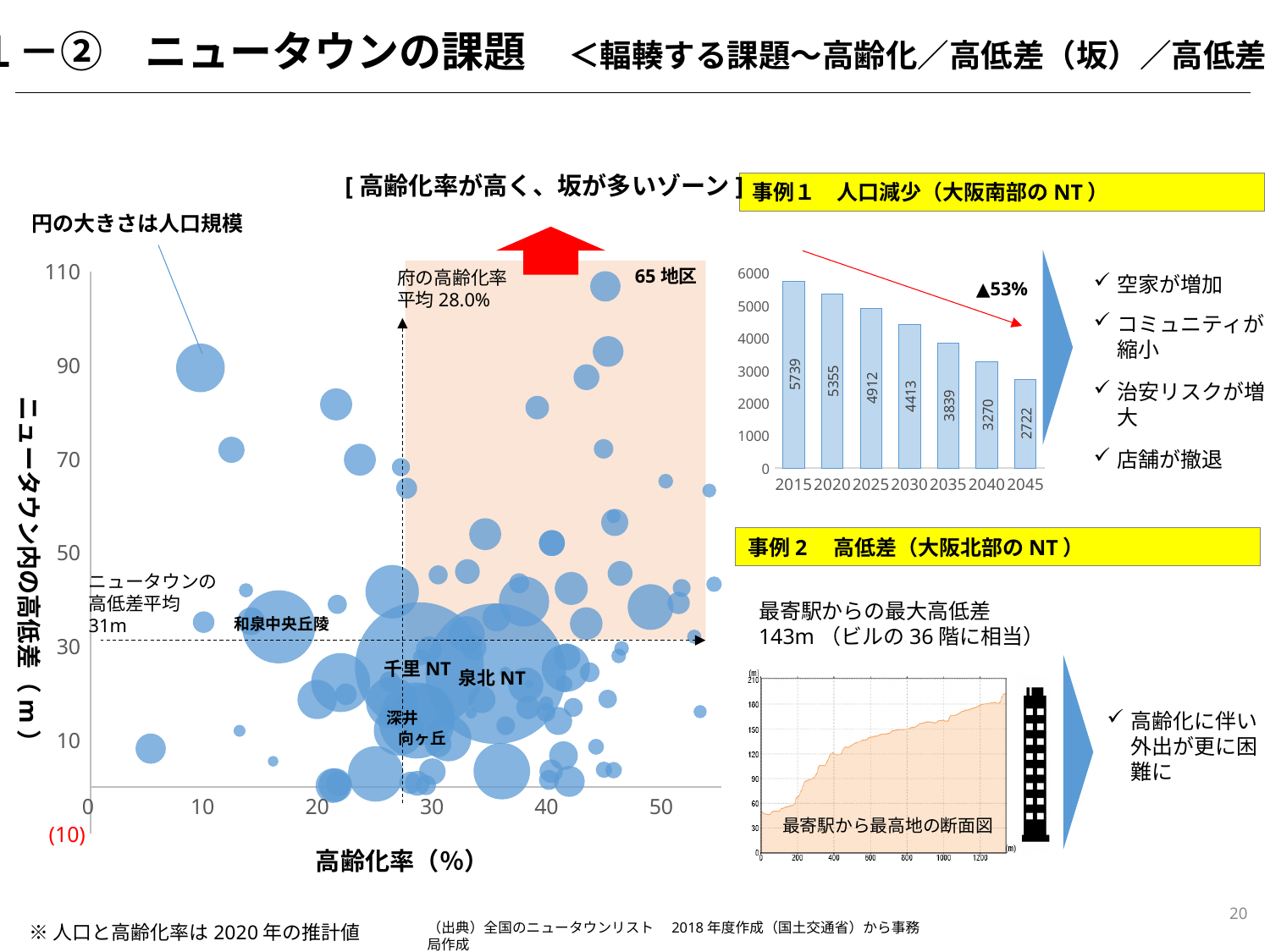
In the bubble chart on the left, what is the prefectural average ageing rate (府の高齢化率平均) marked by the dashed vertical line? 28.0% In the bar chart under 事例1 (人口減少), which year has the lowest value? 2045 In the bubble chart on the left, what is the average elevation difference of new towns (ニュータウンの高低差平均) marked by the dashed horizontal line? 31m In the bar chart under 事例1 (人口減少), what is the value for 2030? 4413 In the bar chart under 事例1 (人口減少), do the values rise or fall from 2015 to 2045? fall In the bar chart under 事例1 (人口減少), what is the value for 2015? 5739 In the bar chart under 事例1 (人口減少), which year has the highest value? 2015 In the bar chart under 事例1 (人口減少), how many years (bars) are shown? 7 In the bar chart under 事例1 (人口減少), what is the difference between the 2015 value and the 2045 value? 3017 What kind of chart is the large chart on the left with 高齢化率 (%) on the x axis? bubble chart In the bar chart under 事例1 (人口減少), what is the value for 2045? 2722 In the bar chart under 事例1 (人口減少), what percentage decline is annotated on the chart? ▲53%